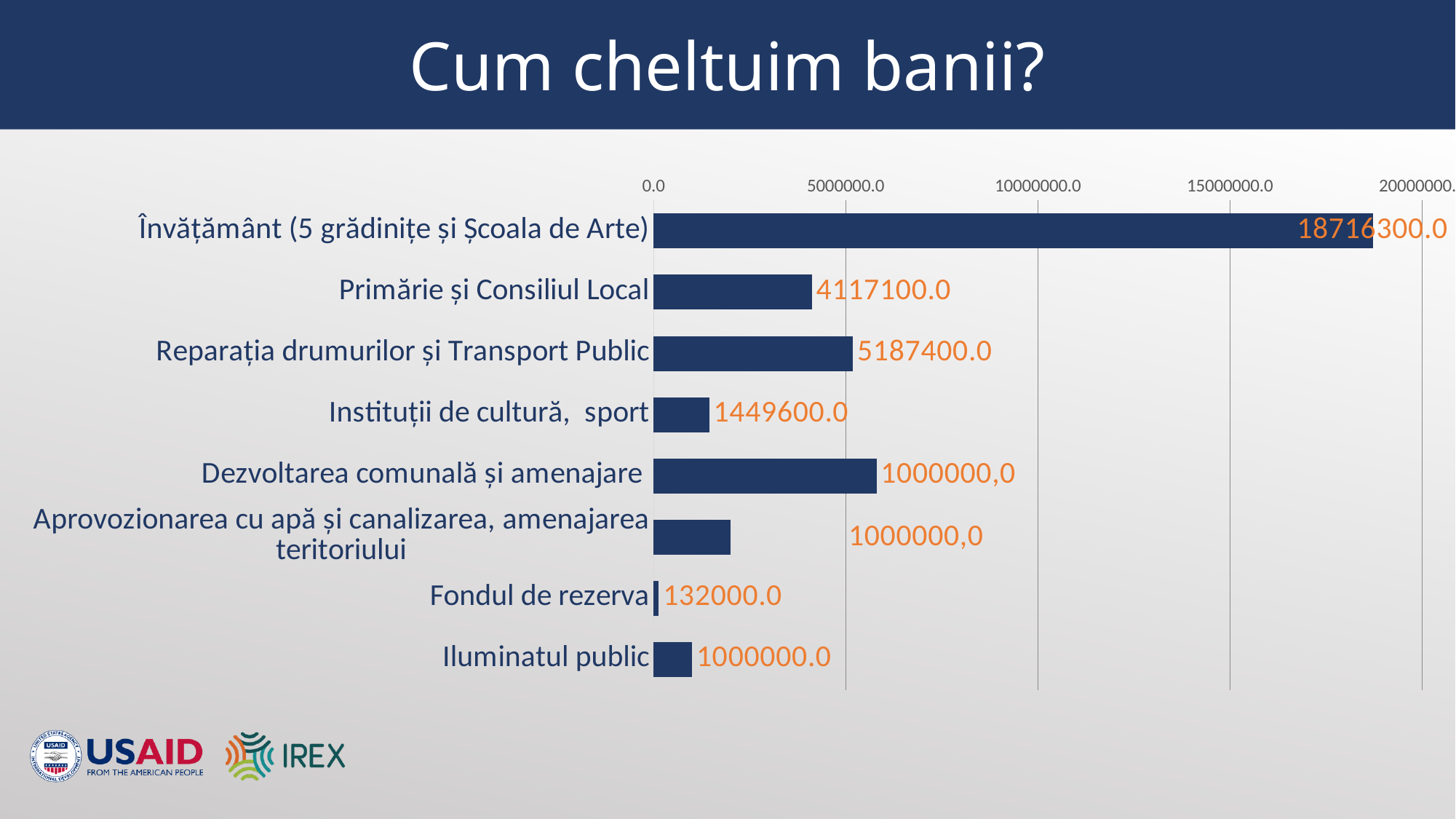
Which category has the highest value? Învățământ (5 grădinițe și Școala de Arte) What is the title of the chart on the slide? Cum cheltuim banii? What type of chart is shown on the slide? bar chart How many categories are shown in the chart? 8 What is the value for Fondul de rezerva? 132000.0 What is the value for Instituții de cultură, sport? 1449600.0 What is the difference between Reparația drumurilor și Transport Public and Primărie și Consiliul Local? 1070300.0 Which is larger: Reparația drumurilor și Transport Public or Primărie și Consiliul Local? Reparația drumurilor și Transport Public What is the value for Primărie și Consiliul Local? 4117100.0 Which category has the lowest value? Fondul de rezerva What is the value for Învățământ (5 grădinițe și Școala de Arte)? 18716300.0 What is the value for Reparația drumurilor și Transport Public? 5187400.0